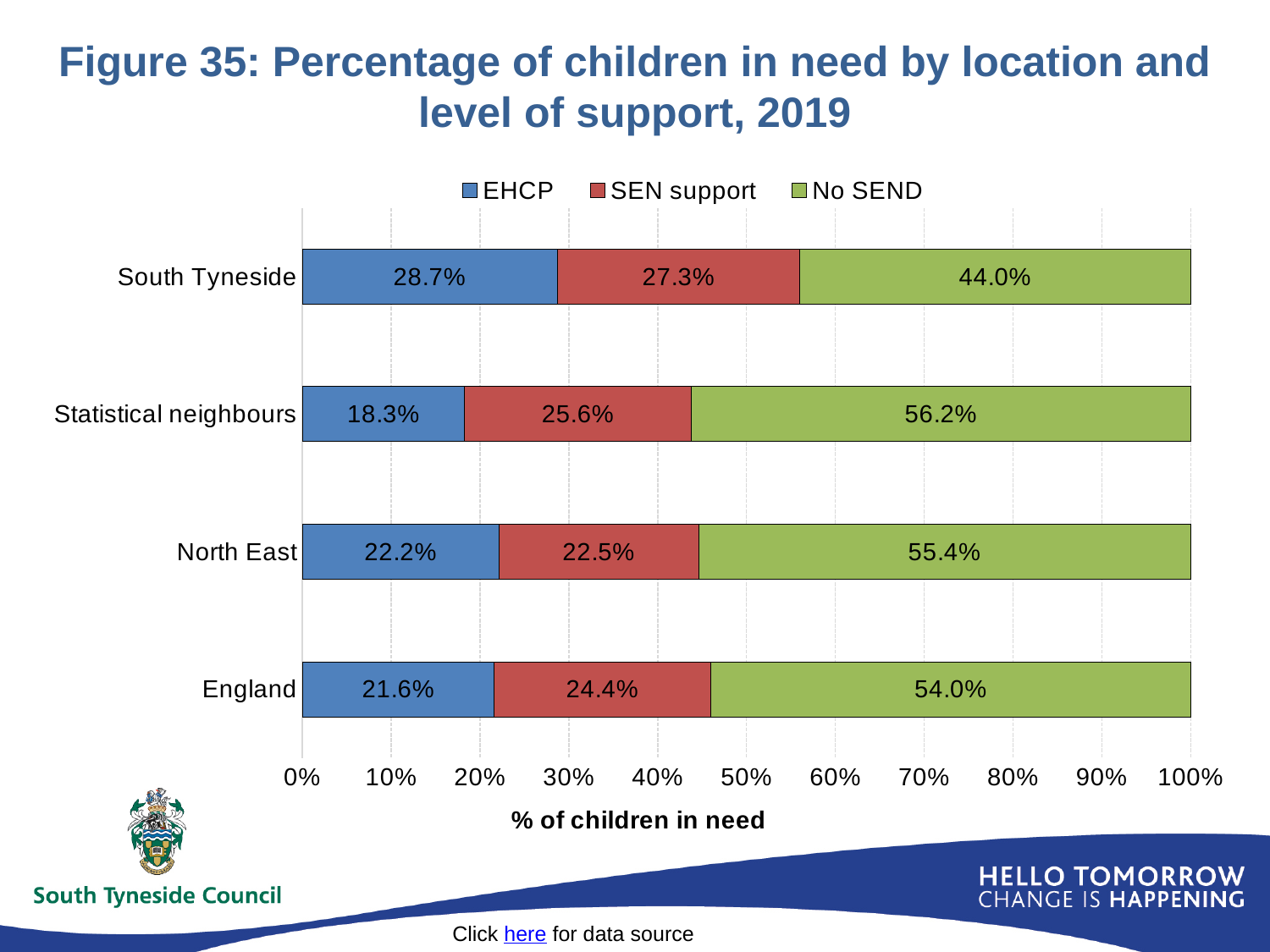
How many percentage points higher is the EHCP value for South Tyneside than for England? 7.1 percentage points What is the SEN support percentage for England? 24.4% Which is larger: the SEN support value for South Tyneside or for Statistical neighbours? South Tyneside How many series does the legend list? 3 How many locations are shown on the chart? 4 Which location has the lowest EHCP percentage? Statistical neighbours What is the No SEND value for Statistical neighbours? 56.2% Which location has the highest No SEND percentage? Statistical neighbours Which location has the highest EHCP percentage? South Tyneside What type of chart is shown on the slide? Stacked bar chart What is the EHCP value for the North East? 22.2% What percentage of children in need in South Tyneside have an EHCP? 28.7%